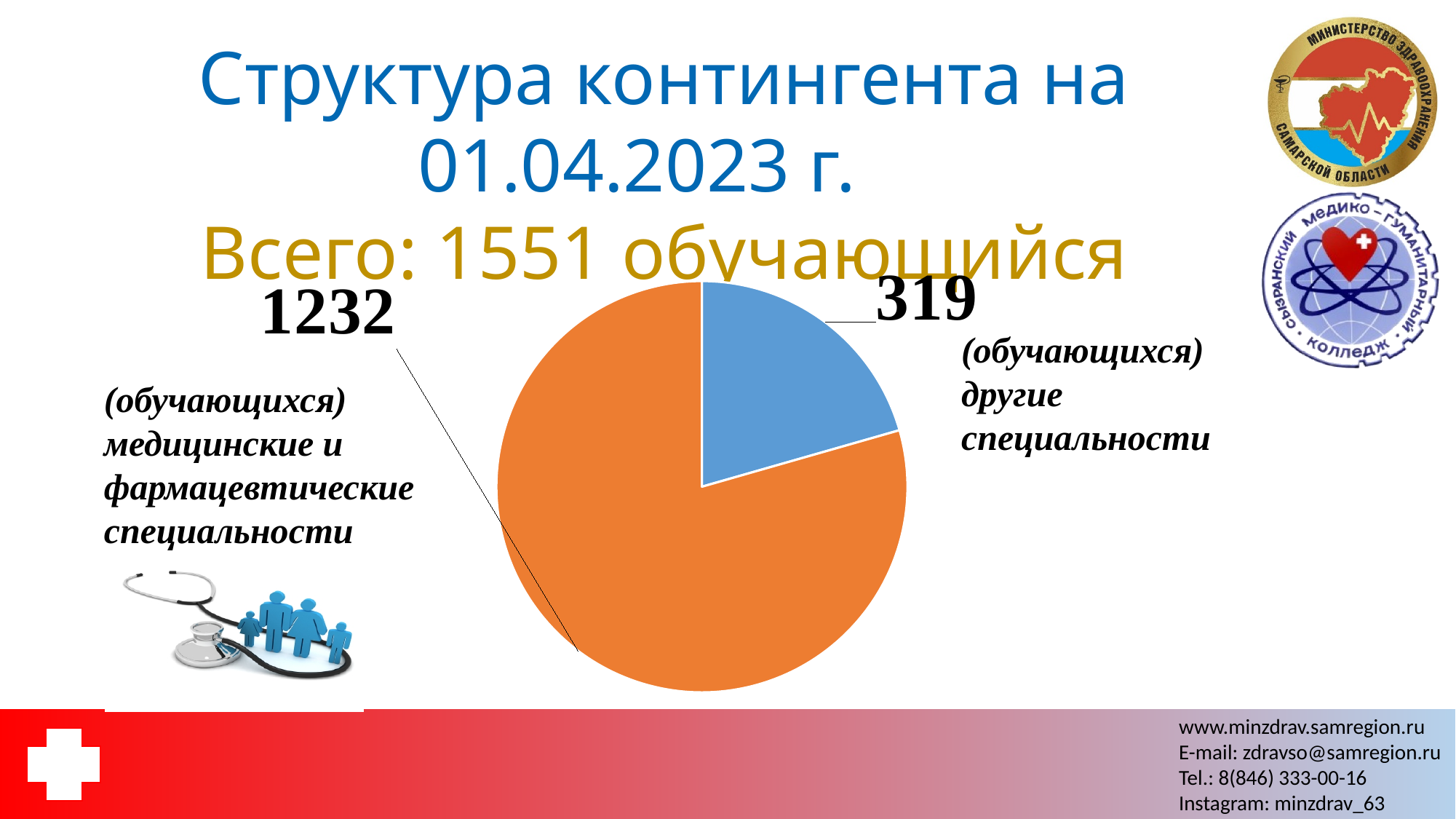
What is the total number of students shown across both slices of the pie? 1551 What type of chart is shown on the slide? pie chart How many slices does the pie chart have? 2 How many students are in other specialties (другие специальности)? 319 What total number of students is stated in the slide heading? 1551 обучающийся What colour is the slice for medical and pharmaceutical specialties? orange Which category has the larger slice of the pie? медицинские и фармацевтические специальности Which category has the smaller slice of the pie? другие специальности What is the difference between the number of students in medical and pharmaceutical specialties and in other specialties? 913 How many students are in medical and pharmaceutical specialties (медицинские и фармацевтические специальности)? 1232 Is the value for other specialties larger or smaller than the value for medical and pharmaceutical specialties? smaller